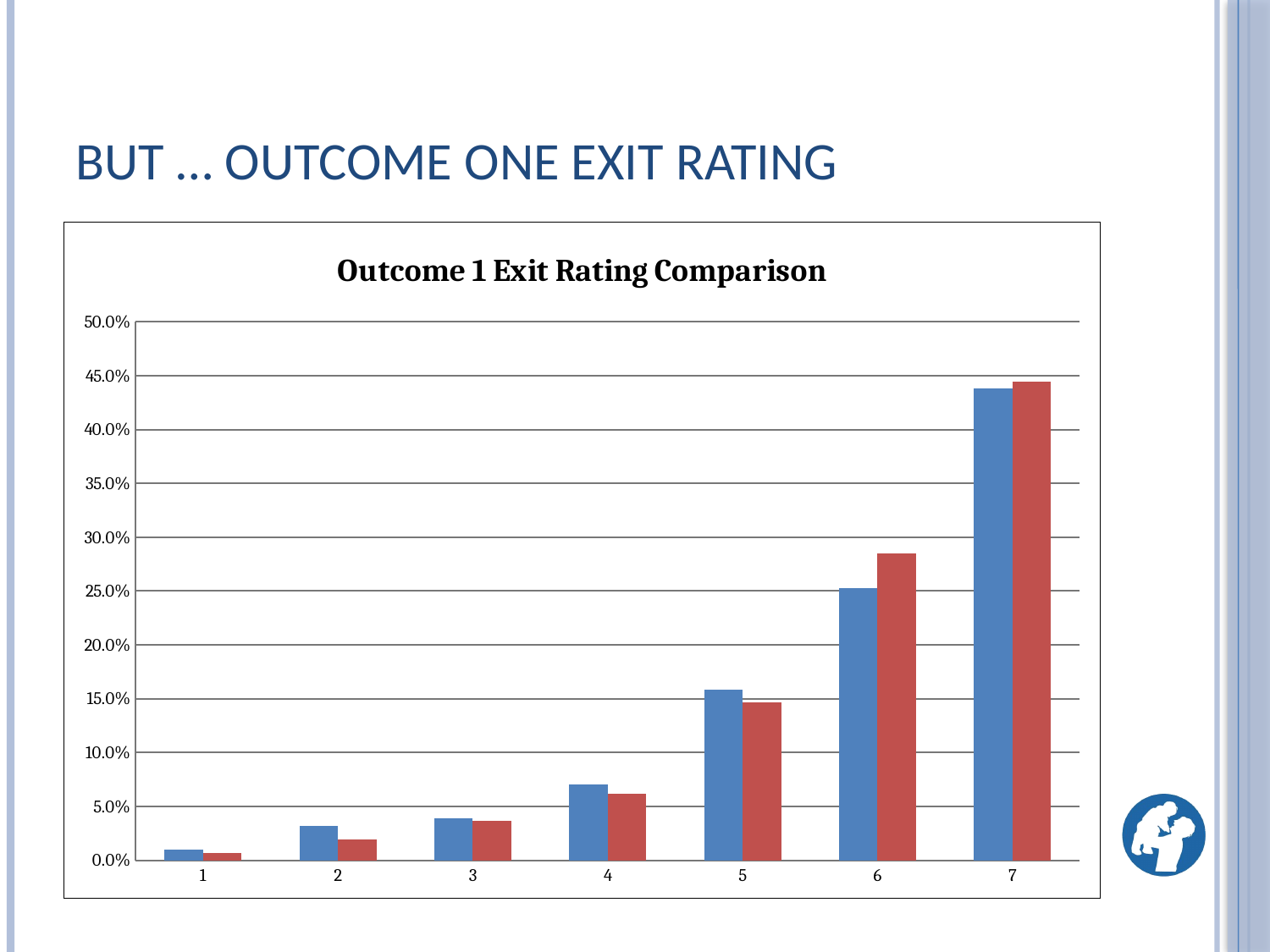
What is the title of the chart? Outcome 1 Exit Rating Comparison Which category has the lowest values on the chart? 1 Is the value of the red bar for category 6 greater or less than 25.0%? greater Is the value of the red bar for category 5 greater or less than 15.0%? less What kind of chart is shown on the slide? bar chart For category 6, which bar is larger, the blue bar or the red bar? red bar Is the value of the blue bar for category 7 greater or less than 40.0%? greater How many bars are plotted for each category on the chart? 2 How many categories are shown along the x axis of the chart? 7 Do the values generally rise or fall moving from category 1 to category 7? rise Which category has the highest values on the chart? 7